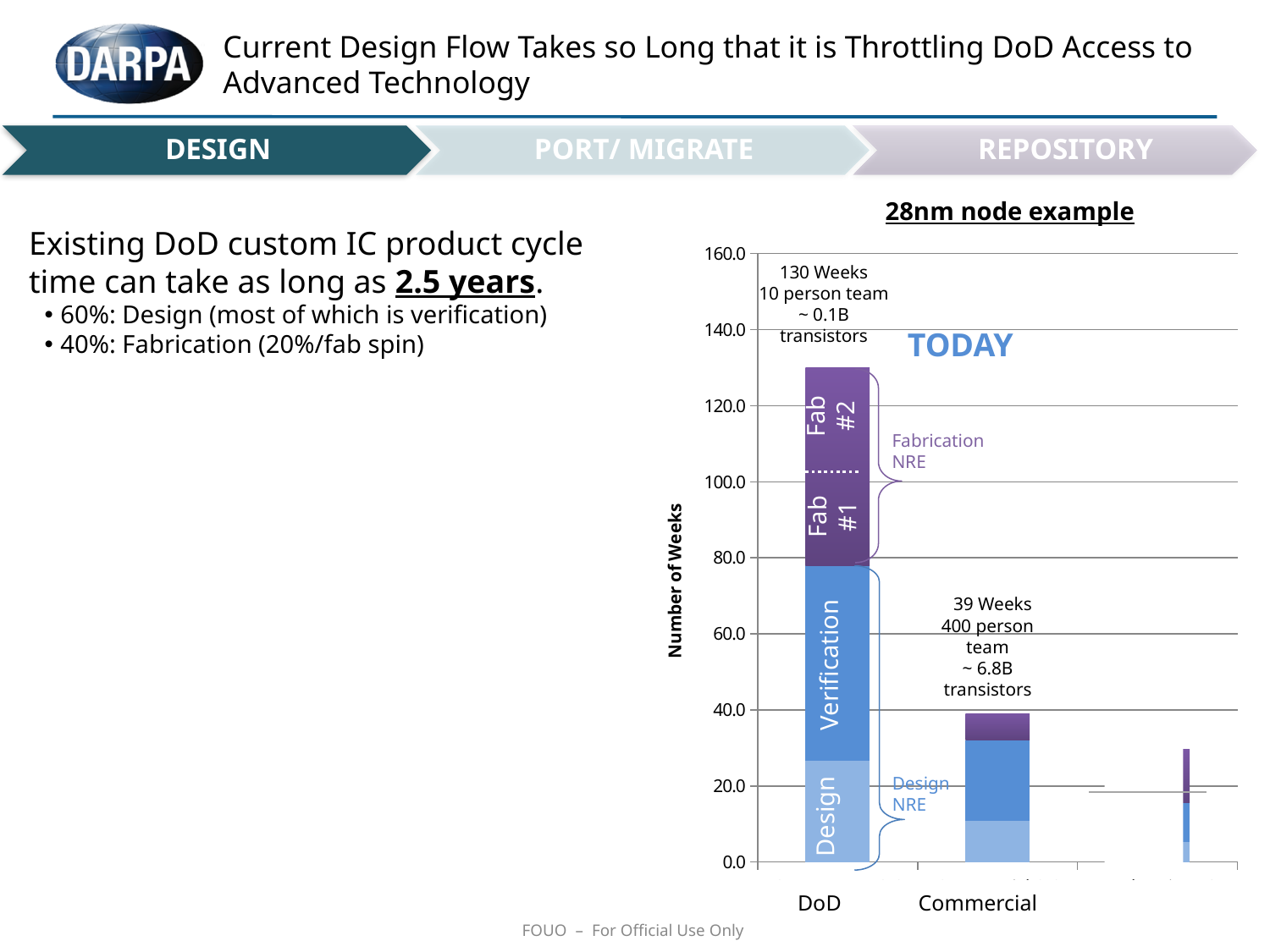
Which bar is taller, DoD or Commercial? DoD What is the label of the y axis? Number of Weeks How many weeks does the DoD bar represent in total? 130 Weeks Is the top of the Design segment in the DoD bar greater or less than 40? less How many weeks does the Commercial bar represent in total? 39 Weeks How many segments make up the DoD stacked bar? 4 Is the total for the DoD bar greater or less than 120? greater What kind of chart is shown on the slide? bar chart What team size is noted for the Commercial bar? 400 person team What is the difference in weeks between the DoD bar and the Commercial bar? 91 weeks Which segment of the DoD bar is the largest? Verification Is the total for the Commercial bar greater or less than 60? less